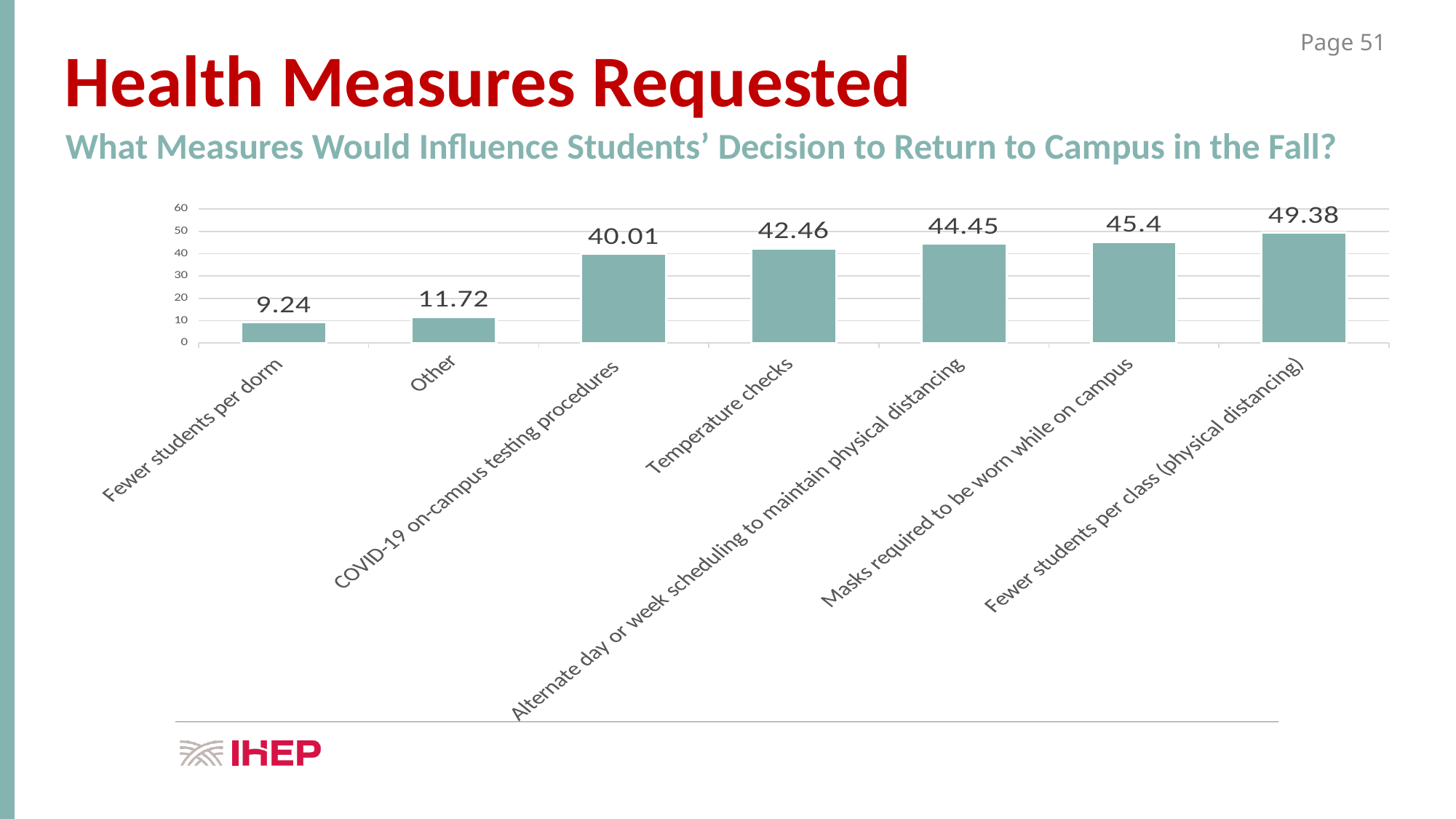
Which category has the lowest value? Fewer students per dorm What is the value for Masks required to be worn while on campus? 45.4 Do the values rise or fall from left to right along the x axis? rise What is the difference between the values for Fewer students per class (physical distancing) and Fewer students per dorm? 40.14 What is the difference between the values for Other and Fewer students per dorm? 2.48 Which category has the highest value? Fewer students per class (physical distancing) What is the value for Fewer students per dorm? 9.24 Which is larger, the value for COVID-19 on-campus testing procedures or the value for Alternate day or week scheduling to maintain physical distancing? Alternate day or week scheduling to maintain physical distancing What kind of chart is shown on the slide? bar chart How many categories are shown in the chart? 7 What is the value for Temperature checks? 42.46 Is the value for Other greater or less than 20? less